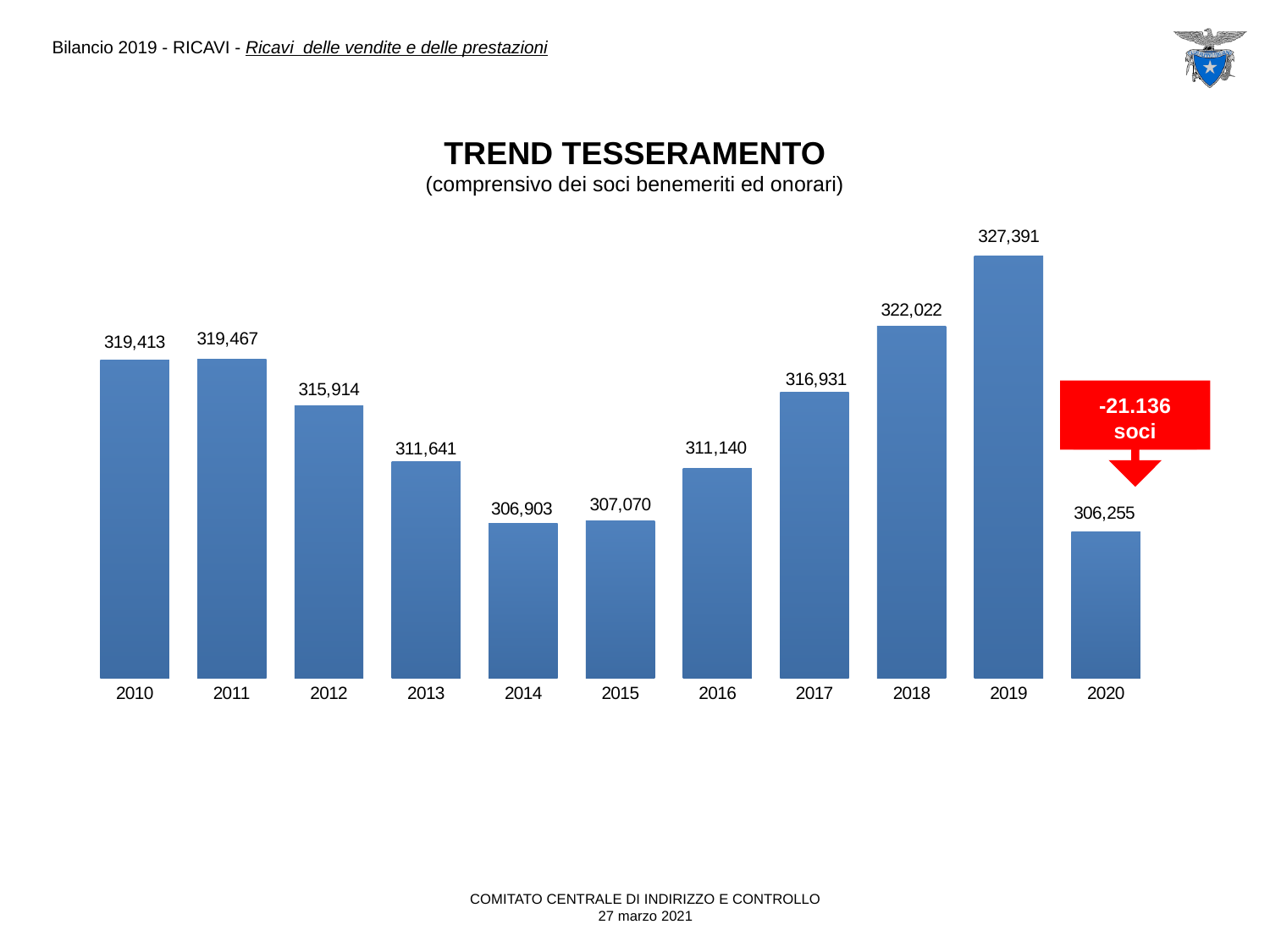
Which is larger, the value for 2010 or the value for 2011? 2011 What is the value for 2020? 306,255 What kind of chart is shown on the slide? Bar chart How many years are shown on the x axis? 11 What is the difference between the values for 2019 and 2020? 21,136 Which year has the lowest value? 2020 Which year has the highest value? 2019 What is the title of the chart? TREND TESSERAMENTO What is the value for 2014? 306,903 What is the difference between the values for 2018 and 2017? 5,091 What is the value for 2019? 327,391 Do the values rise or fall from 2014 to 2019? Rise